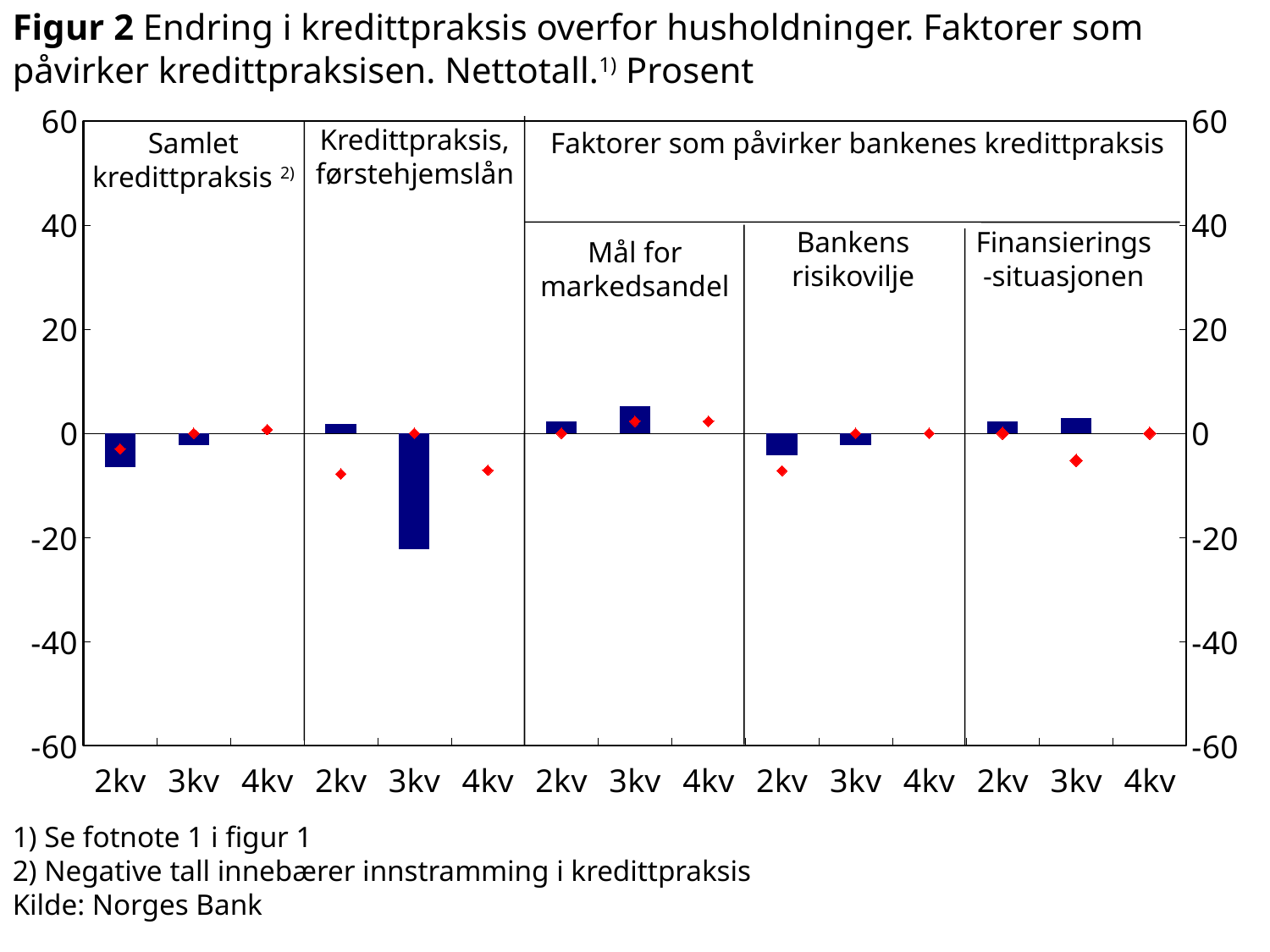
Which quarter and panel has the lowest (most negative) bar in the chart? 3kv, Kredittpraksis, førstehjemslån What is the heading above the three rightmost panels of the chart? Faktorer som påvirker bankenes kredittpraksis In the 'Bankens risikovilje' panel, which bar is lower, 2kv or 3kv? 2kv In the 'Kredittpraksis, førstehjemslån' panel, is the bar for 3kv greater or less than -10? less What is the source given for the chart? Norges Bank In the 'Samlet kredittpraksis' panel, which bar is lower, 2kv or 3kv? 2kv In the 'Mål for markedsandel' panel, is the bar for 3kv greater or less than 0? greater How many panels (sections) is the chart divided into? 5 In the 'Mål for markedsandel' panel, which bar is higher, 2kv or 3kv? 3kv How many quarter labels appear along the x axis in total? 15 In the 'Samlet kredittpraksis' panel, is the bar for 2kv greater or less than 0? less What kind of chart is shown on the slide? combination bar and line chart (bars with diamond markers)